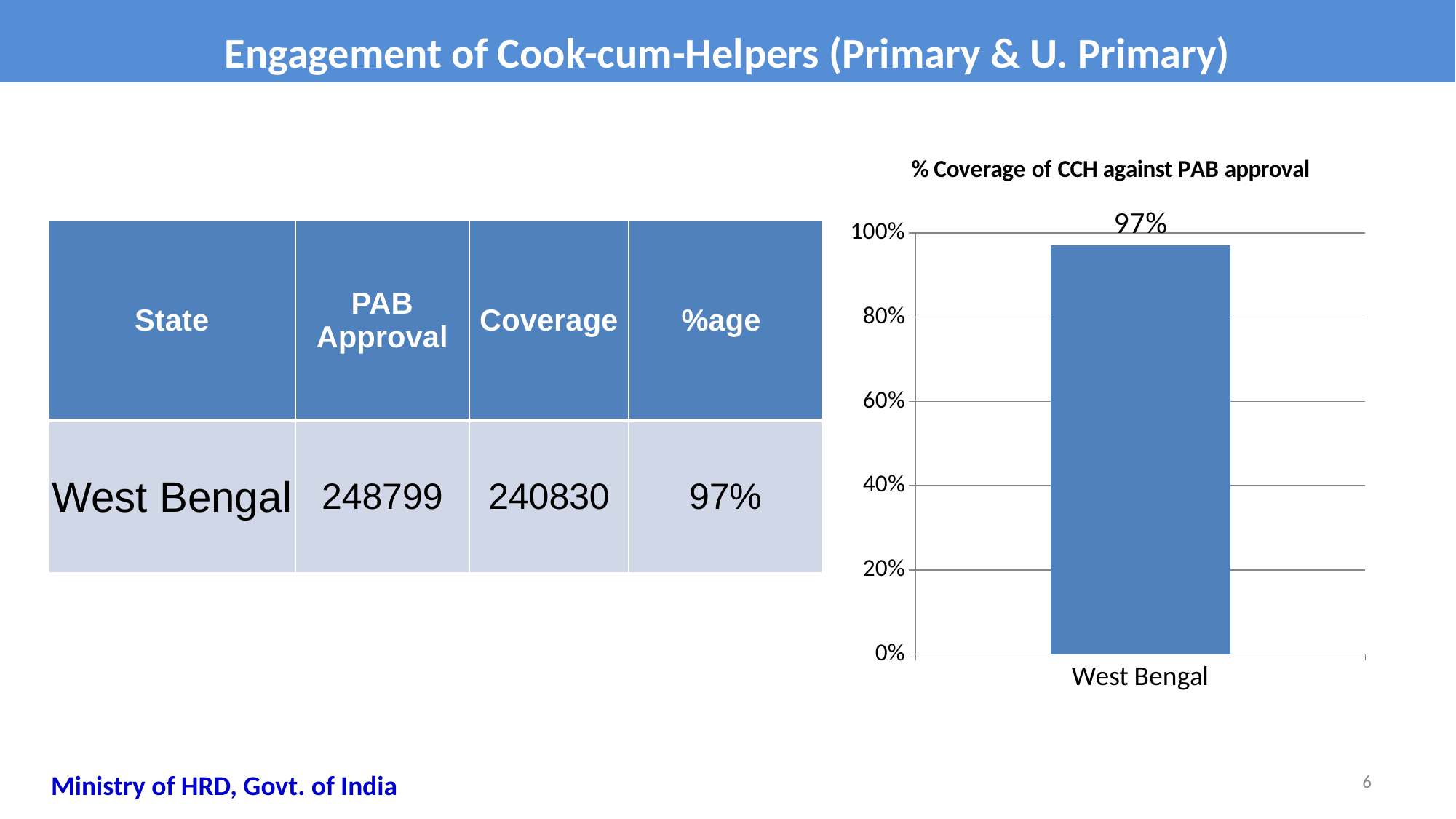
Which category is shown on the x axis of the chart? West Bengal What kind of chart is shown on the slide? bar chart What is the highest value shown on the chart's y axis? 100% How many categories are plotted in the chart? 1 What is the title of the chart? % Coverage of CCH against PAB approval What is the value for West Bengal in the chart? 97% Is the value for West Bengal greater or less than 100%? less Is the value for West Bengal greater or less than 80%? greater